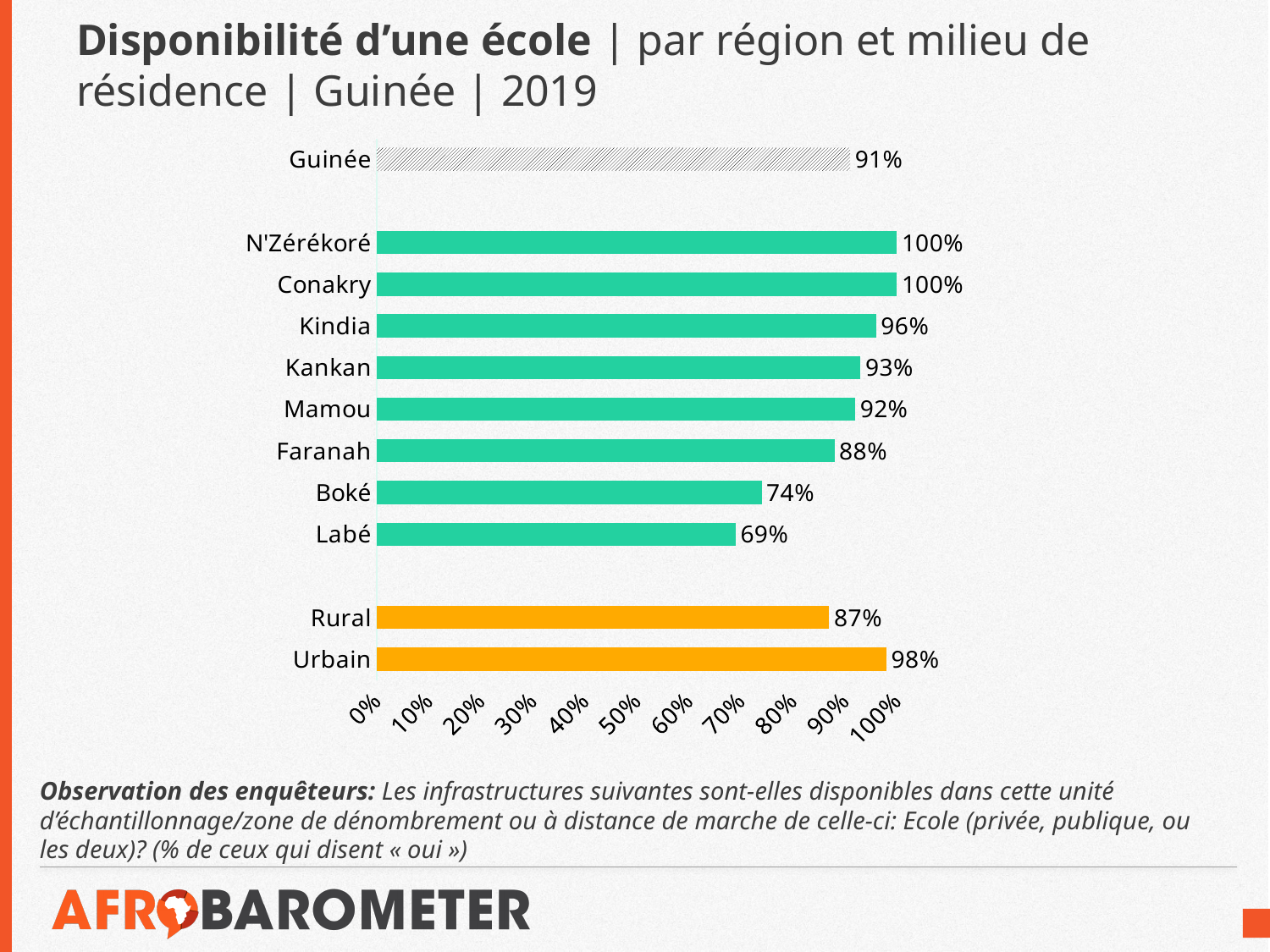
Which is larger, the value for Kankan or the value for Mamou? Kankan What is the value for Faranah? 88% What is the value for Rural? 87% Which region has the lowest value? Labé Which regions have the highest value? N'Zérékoré and Conakry What is the difference between the values for Kindia and Boké? 22% What is the value for Guinée? 91% What is the year shown in the chart title? 2019 What kind of chart is shown on the slide? Bar chart How many bars are plotted on the chart? 11 What is the difference between the values for Urbain and Rural? 11% What is the value for Labé? 69%